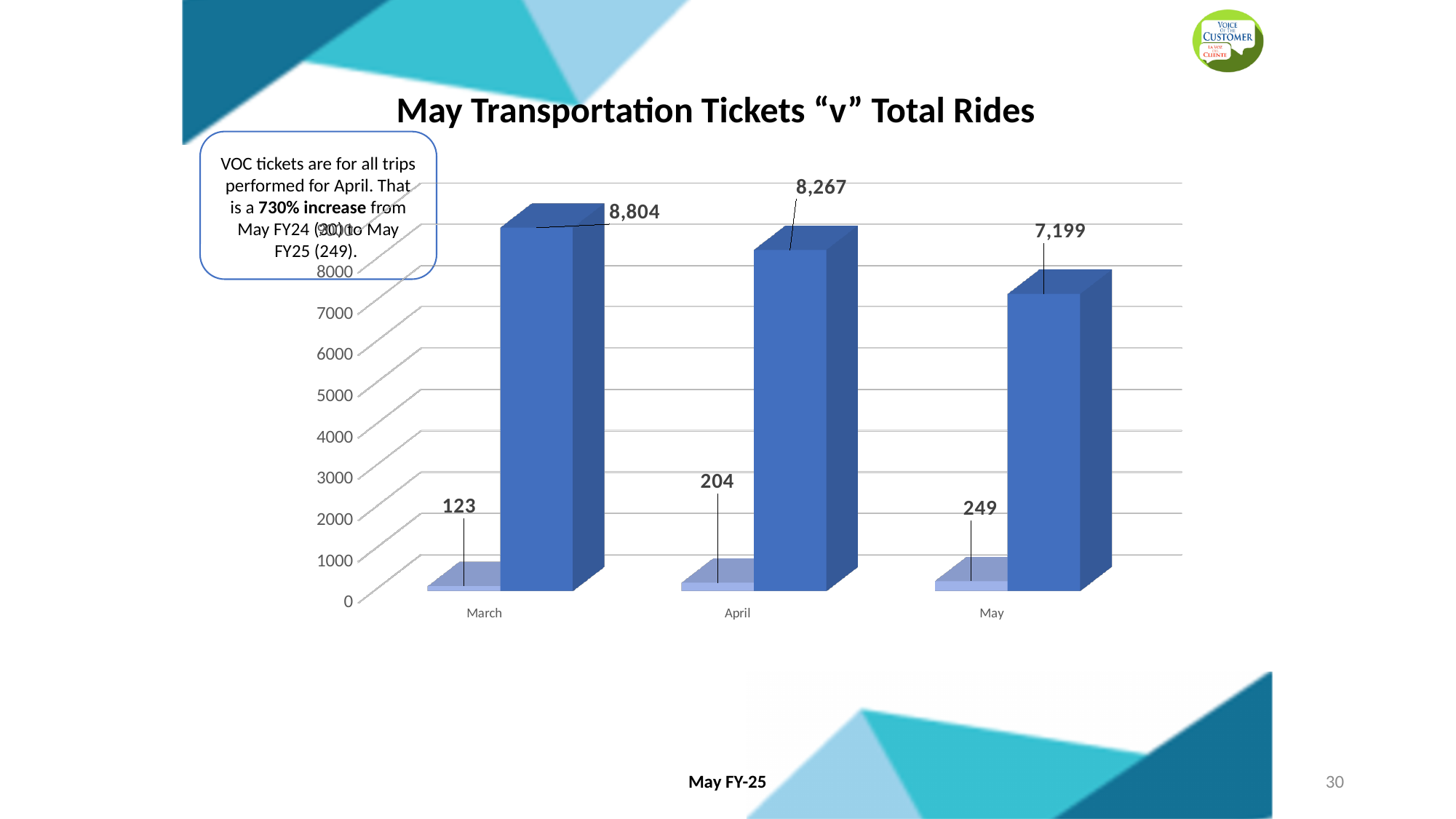
What is the difference between the taller bar values for March (8,804) and May (7,199)? 1,605 Do the taller bar values rise or fall from March to May? Fall What is the value shown on the shorter bar for March? 123 Which month has the lowest value among the shorter bars? March What is the value shown on the taller bar for March? 8,804 What is the value shown on the taller bar for April? 8,267 What is the value shown on the taller bar for May? 7,199 What kind of chart is shown on the slide? Bar chart Which is larger, the shorter bar value for April or for May? May How many months are shown on the x axis? 3 Which month has the highest value among the taller bars? March What is the value shown on the shorter bar for May? 249